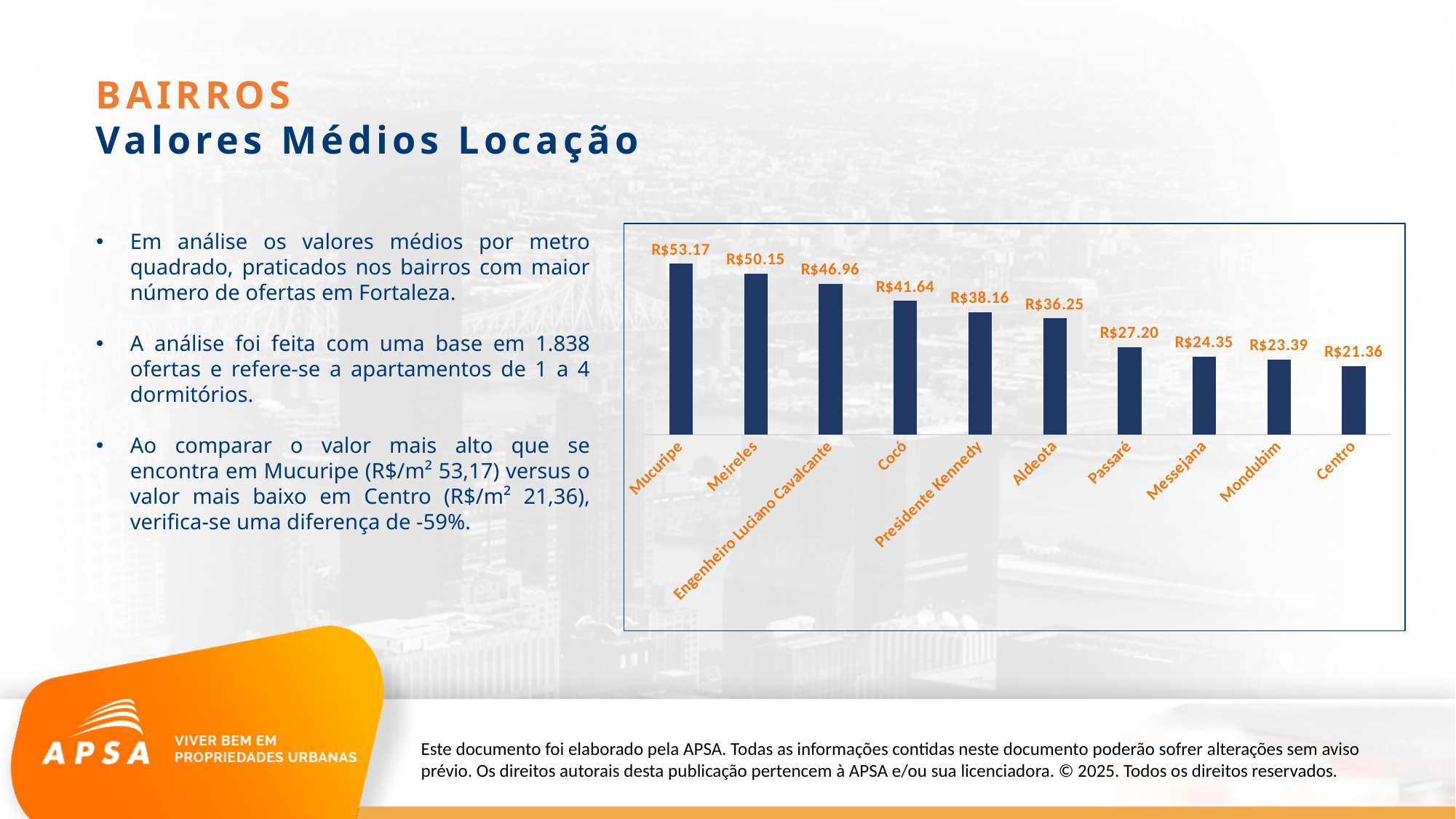
Which neighbourhood has the lowest value in the chart? Centro What is the value shown for Cocó? R$41.64 Which neighbourhood has the highest value in the chart? Mucuripe How many neighbourhoods are shown in the chart? 10 What is the difference between the values for Meireles and Aldeota? R$13.90 Do the values rise or fall from left to right along the x axis? Fall What is the value shown for Mucuripe? R$53.17 What is the difference between the values for Mucuripe and Centro? R$31.81 What kind of chart is shown on the slide? Bar chart What is the value shown for Messejana? R$24.35 What is the value shown for Engenheiro Luciano Cavalcante? R$46.96 Which has a larger value, Presidente Kennedy or Passaré? Presidente Kennedy